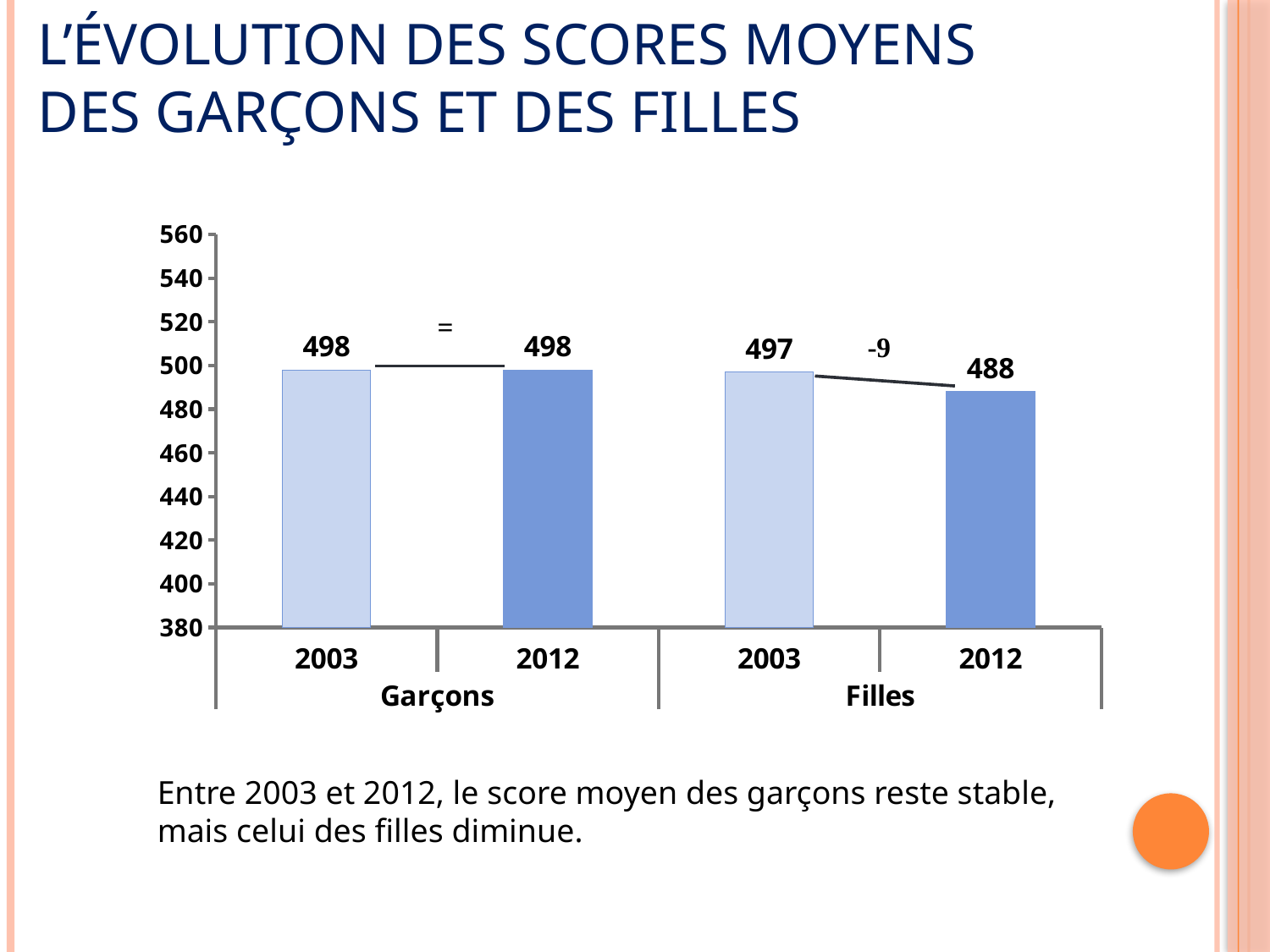
Is the value for Filles in 2012 greater or less than 500? less What is the average score for Garçons in 2003? 498 What is the average score for Filles in 2003? 497 What kind of chart is shown on the slide? bar chart What is the average score for Filles in 2012? 488 How many bars are plotted on the chart? 4 What is the difference between the Filles score in 2003 and in 2012? 9 What change is annotated between the two Garçons bars? = Which bar has the lowest value on the chart? Filles 2012 Which is larger, the Garçons score in 2012 or the Filles score in 2012? Garçons 2012 What is the average score for Garçons in 2012? 498 Do the Filles scores rise or fall from 2003 to 2012? fall